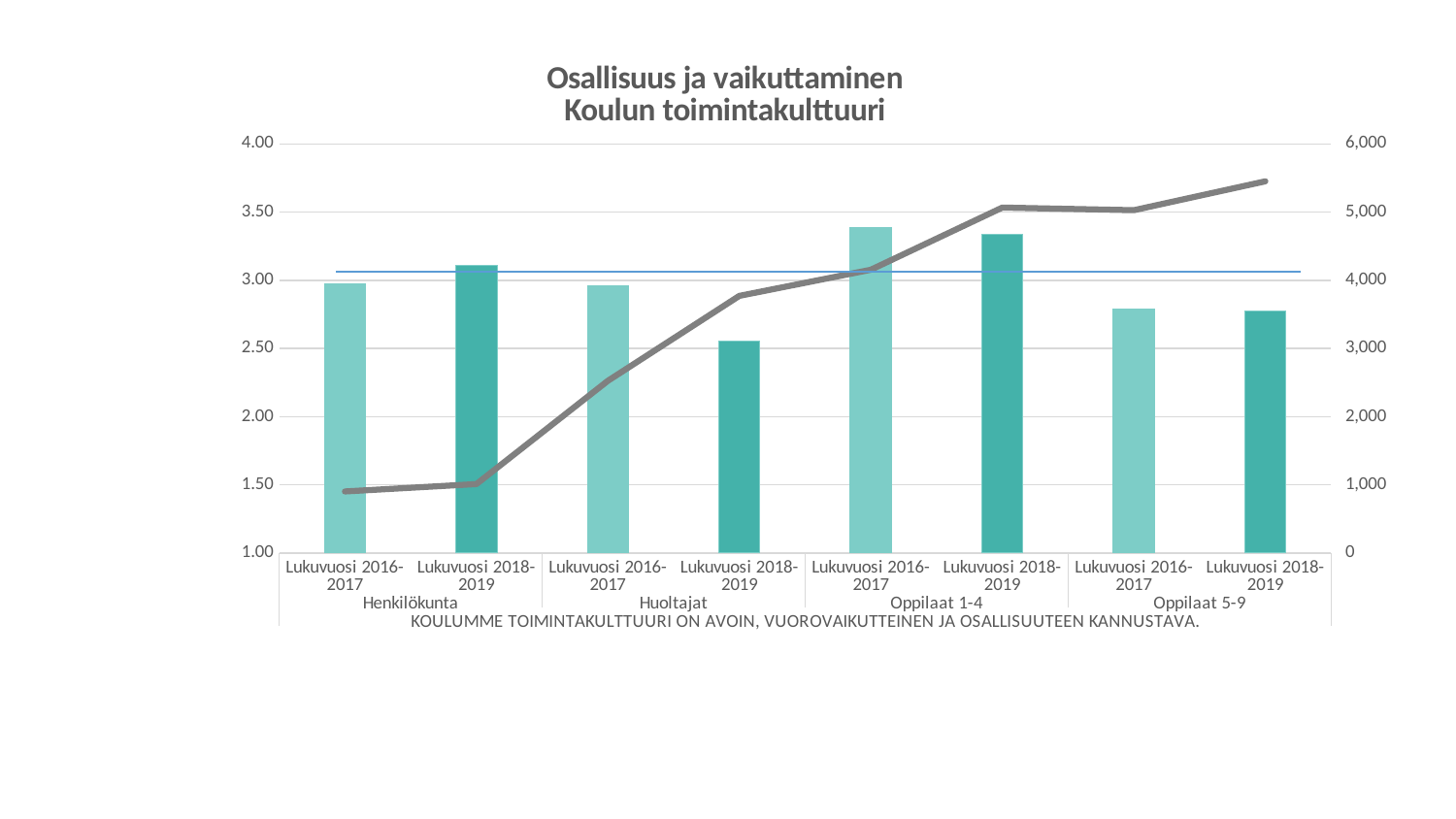
Is the bar for Oppilaat 1-4 Lukuvuosi 2016-2017 greater or less than 3.00? greater Is the bar for Oppilaat 5-9 Lukuvuosi 2018-2019 greater or less than 3.00? less What is the maximum value shown on the right-hand vertical axis? 6,000 Which bar is the lowest in the chart? Huoltajat, Lukuvuosi 2018-2019 How many bars are plotted in the chart? 8 For Huoltajat, which bar is taller: Lukuvuosi 2016-2017 or Lukuvuosi 2018-2019? Lukuvuosi 2016-2017 How many respondent groups are shown along the x axis? 4 Does the grey line generally rise or fall from left to right across the chart? rise Is the bar for Huoltajat Lukuvuosi 2018-2019 greater or less than 3.00? less For Henkilökunta, which bar is taller: Lukuvuosi 2016-2017 or Lukuvuosi 2018-2019? Lukuvuosi 2018-2019 What is the title of the chart? Osallisuus ja vaikuttaminen Koulun toimintakulttuuri What kind of chart is shown on the slide? Combined bar and line chart